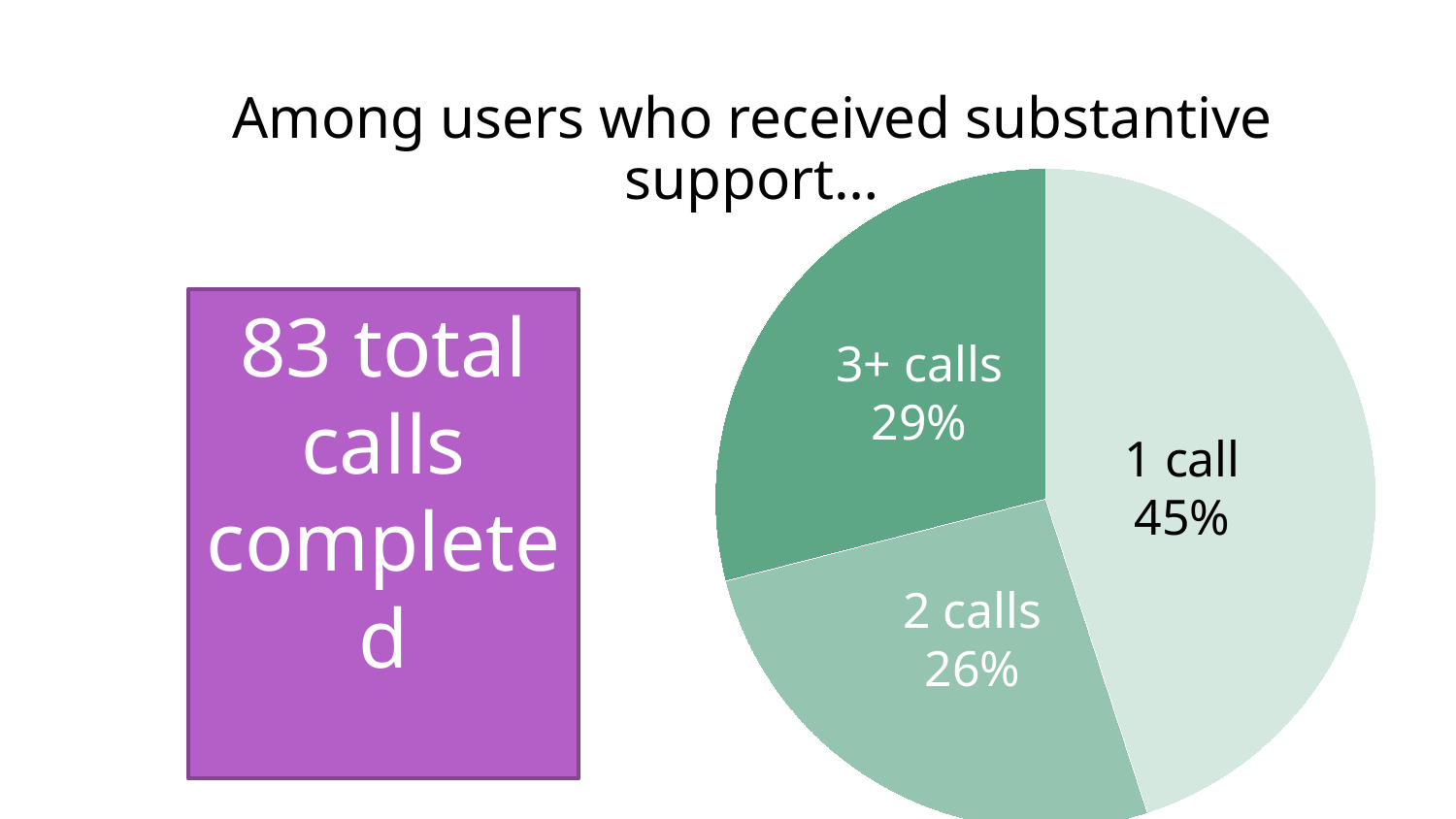
Which slice is larger, "2 calls" or "3+ calls"? 3+ calls What is the difference in percentage points between the "3+ calls" slice and the "2 calls" slice? 3 How many slices does the pie chart have? 3 What share of the pie is labelled "3+ calls"? 29% How many total calls completed does the purple box on the slide report? 83 What kind of chart is shown on the slide? pie chart What is the difference in percentage points between the "1 call" slice and the "3+ calls" slice? 16 What share of the pie is labelled "2 calls"? 26% Which slice of the pie is the smallest? 2 calls Which slice of the pie is the largest? 1 call What share of the pie is labelled "1 call"? 45% What is the title shown above the pie chart? Among users who received substantive support...